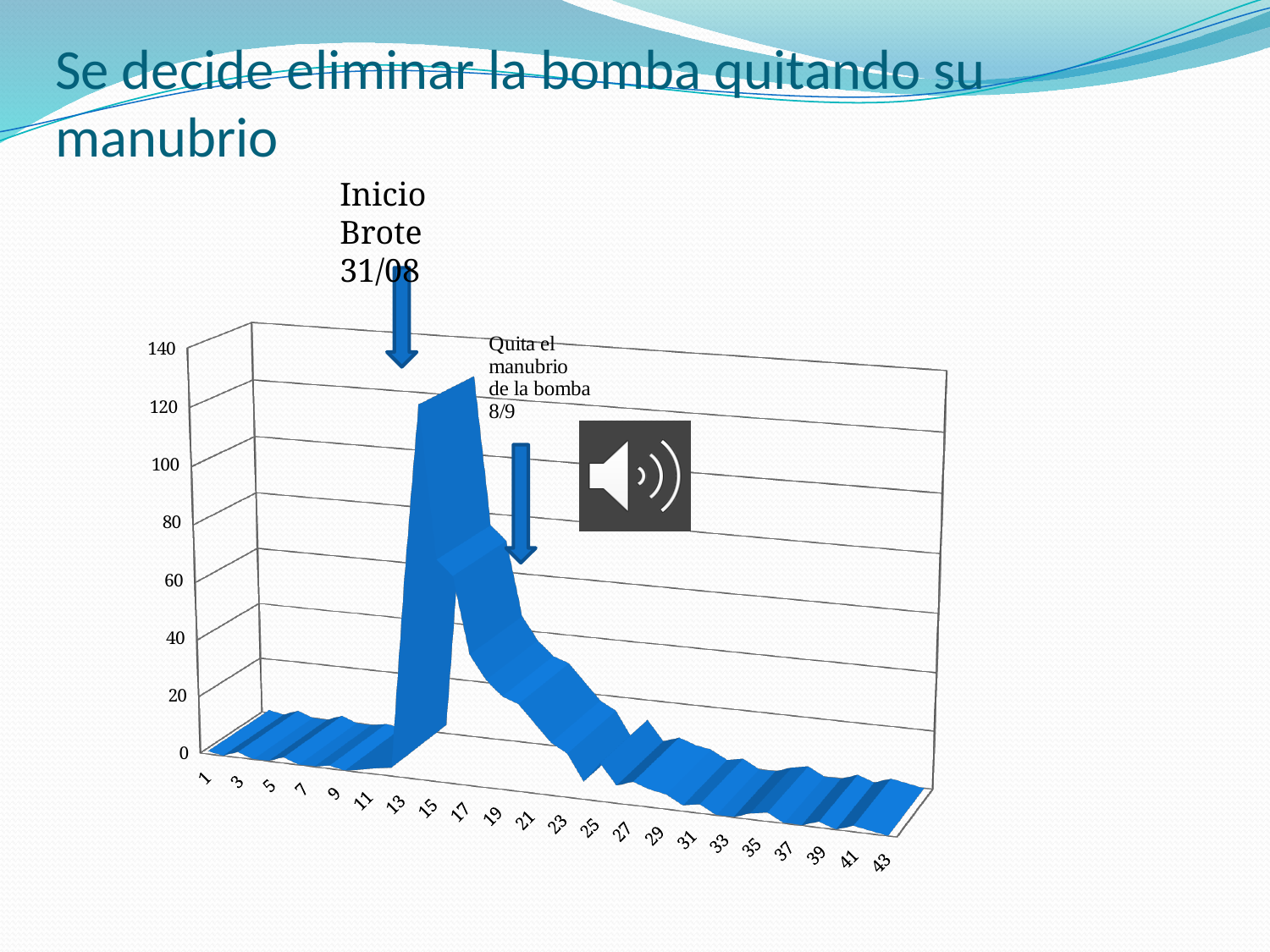
Is the value at category 43 greater or less than 40? less Is the value at category 5 greater or less than 60? less What date is given in the annotation 'Inicio Brote' above the chart? 31/08 Do the values rise or fall along the x axis after the peak near category 15? fall Which is larger, the value at category 15 or the value at category 35? category 15 Is the peak value of the chart greater or less than 80? greater What is the highest value shown on the vertical axis of the chart? 140 What is the last category label shown on the horizontal axis of the chart? 43 Which is larger, the value at category 3 or the value at category 17? category 17 What kind of chart is shown on the slide? Line chart (3D line)